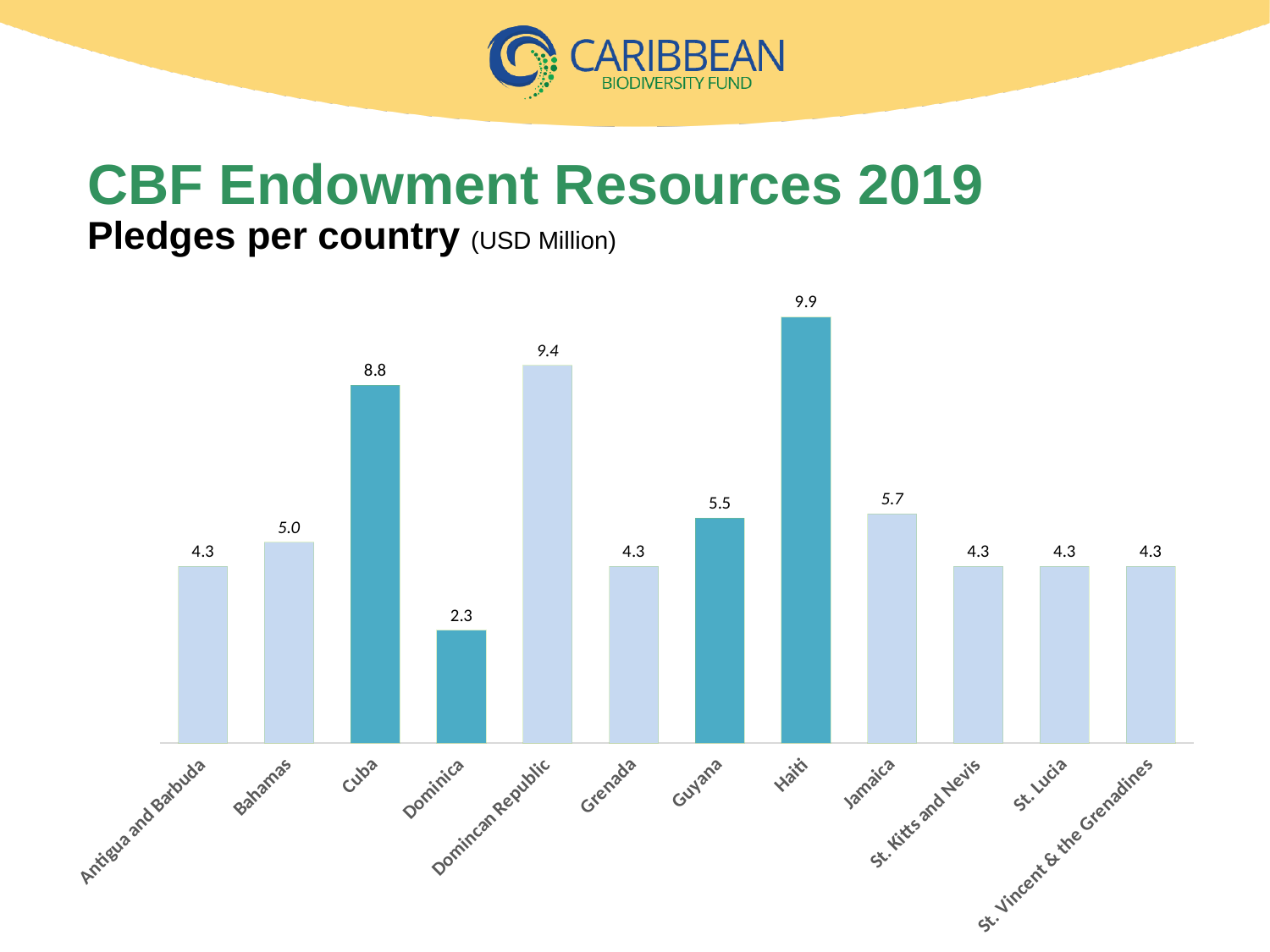
What kind of chart is shown on the slide? Bar chart What is the pledge value for Dominica? 2.3 Which country has the highest pledge? Haiti What is the difference between the pledges of the Domincan Republic and Cuba? 0.6 Which has a larger pledge, Guyana or Jamaica? Jamaica What is the pledge value for Haiti? 9.9 Which country has the lowest pledge? Dominica What is the difference between the pledges of Haiti and Dominica? 7.6 What is the pledge value for Cuba? 8.8 How many countries are shown in the chart? 12 What is the pledge value for Jamaica? 5.7 What unit are the pledge values given in, according to the subtitle? USD Million